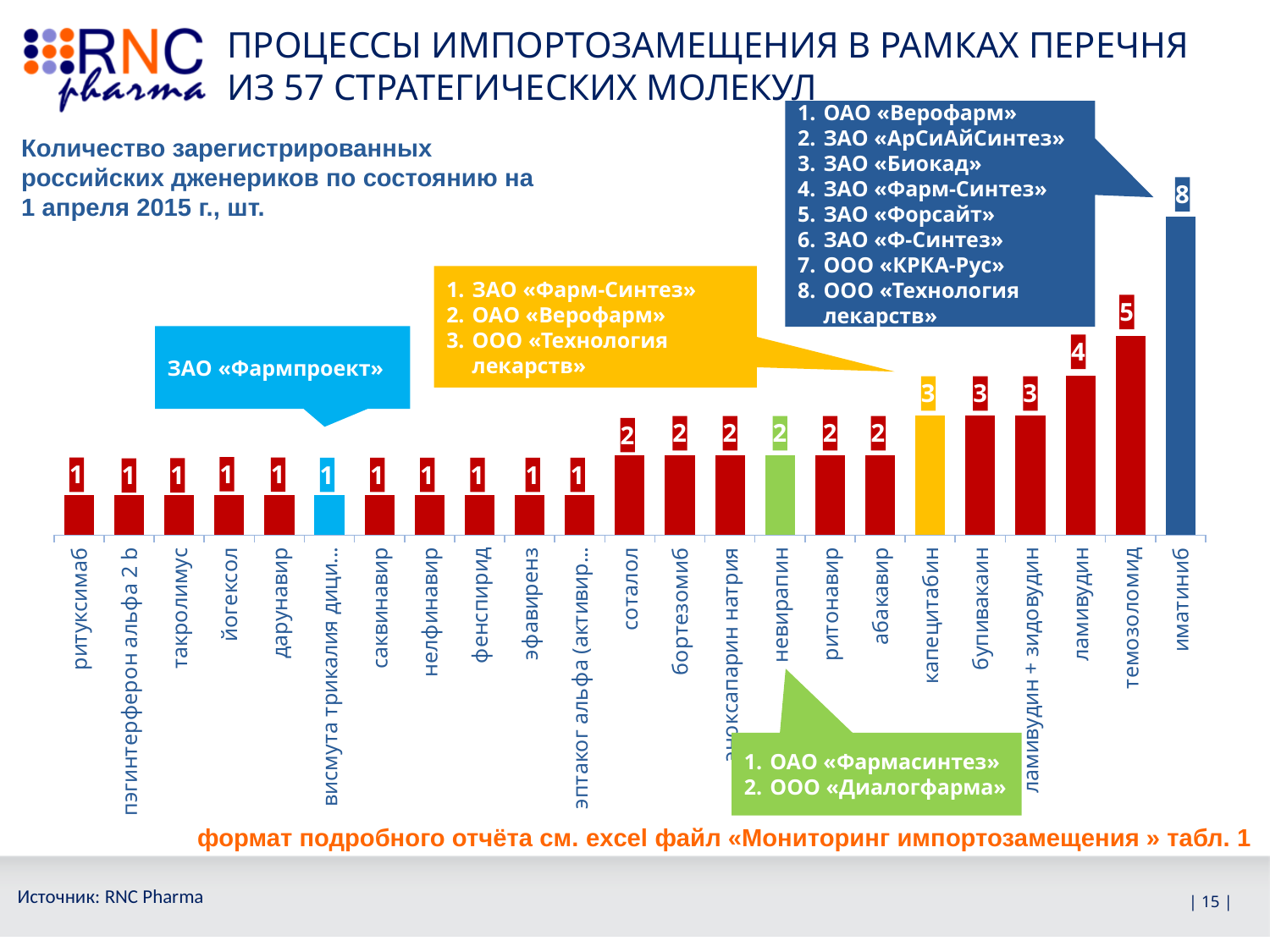
What is the difference between the values for иматиниб and темозоломид? 3 Which category has the highest value? иматиниб What is the value for невирапин? 2 What type of chart is shown on the slide? bar chart What is the value for капецитабин? 3 How many categories are plotted on the chart? 23 Do the values generally rise or fall from left to right along the x axis? rise What is the value for иматиниб? 8 Which has a larger value, ламивудин or бупивакаин? ламивудин What is the value for темозоломид? 5 What is the value for ламивудин? 4 Which company is named in the callout pointing to the bar for невирапин? ОАО «Фармасинтез» and ООО «Диалогфарма»